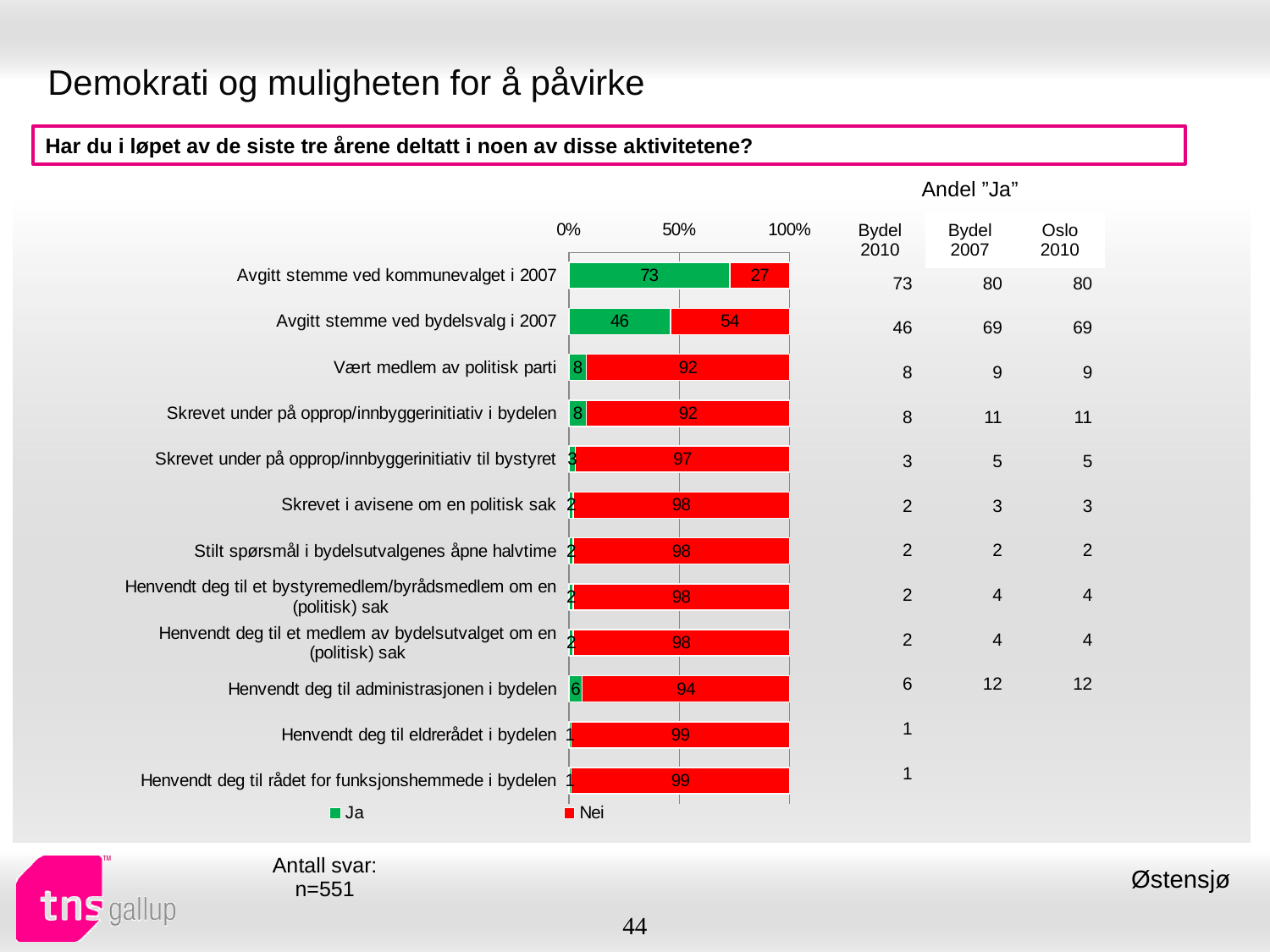
What is the total of the stacked bar for "Avgitt stemme ved kommunevalget i 2007"? 100 Is the "Nei" value for "Avgitt stemme ved kommunevalget i 2007" greater or less than 50%? less How many series does the legend list? 2 What is the "Nei" value for "Avgitt stemme ved bydelsvalg i 2007"? 54 Which colour represents the "Nei" series in the chart? Red Which category has the highest "Ja" value? Avgitt stemme ved kommunevalget i 2007 What is the "Nei" value for "Vært medlem av politisk parti"? 92 Which is larger: the "Ja" value for "Henvendt deg til administrasjonen i bydelen" or for "Vært medlem av politisk parti"? Vært medlem av politisk parti How many categories (activities) are plotted in the chart? 12 What kind of chart is shown on the slide? Stacked bar chart What is the "Ja" value for "Avgitt stemme ved kommunevalget i 2007"? 73 What is the difference between the "Ja" values for "Avgitt stemme ved kommunevalget i 2007" and "Avgitt stemme ved bydelsvalg i 2007"? 27